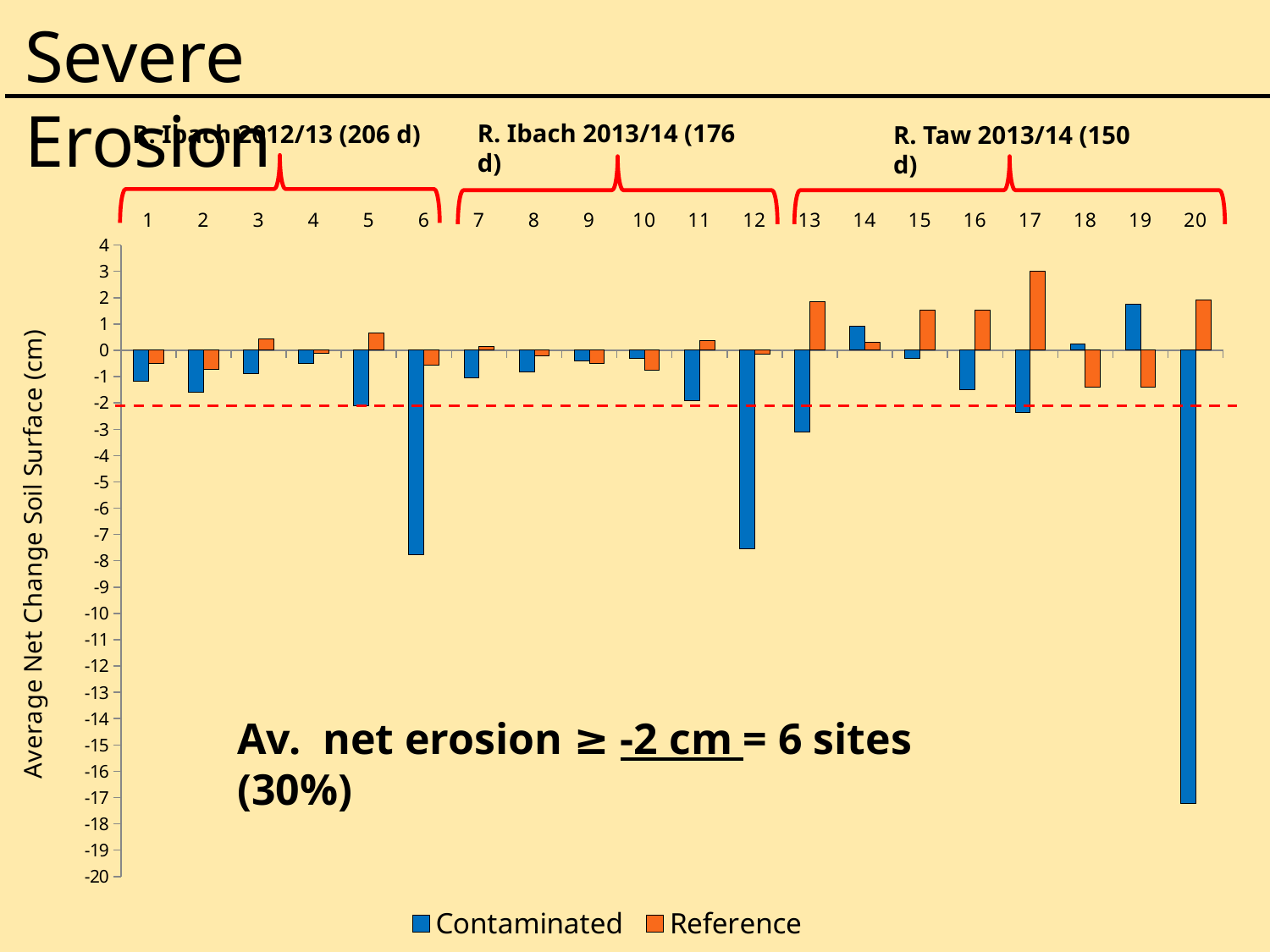
Is the Contaminated value for site 6 greater or less than -5? less How many sites (categories) are plotted along the x axis? 20 Which site has the highest Reference value? 17 What kind of chart is shown on the slide? bar chart How many series does the legend list? 2 What is the label on the vertical axis? Average Net Change Soil Surface (cm) Which is larger, the Contaminated value for site 6 or the Contaminated value for site 20? site 6 Is the Contaminated value for site 20 greater or less than -10? less What are the two series named in the legend? Contaminated and Reference Is the Reference value for site 17 greater or less than 2? greater Which site has the lowest Contaminated value? 20